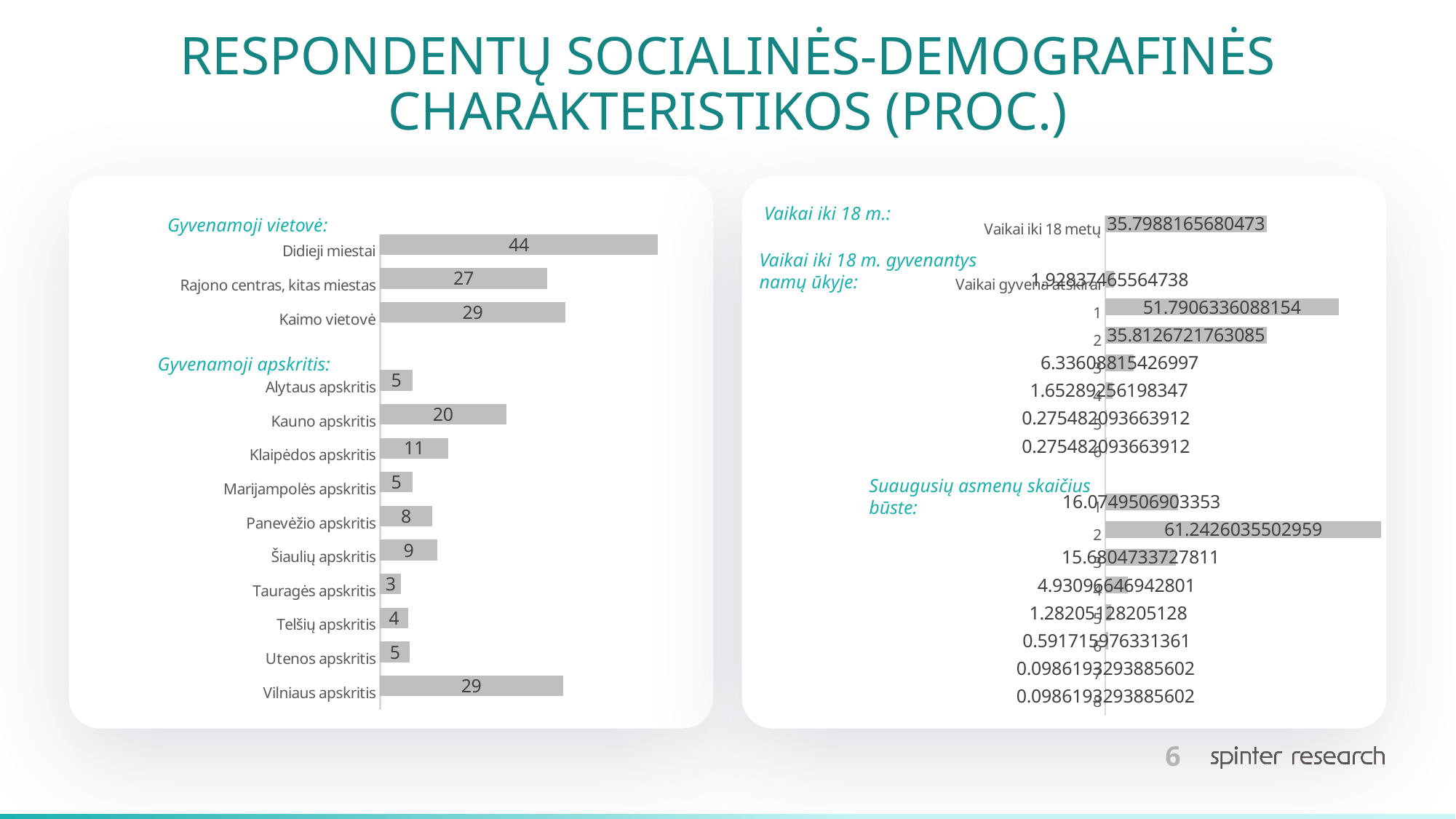
In the left chart, what is the value for Didieji miestai? 44 In the left chart, what is the difference between the values for Vilniaus apskritis and Kauno apskritis? 9 In the left chart, which apskritis (county) has the lowest value? Tauragės apskritis In the left chart, which category has the highest value overall? Didieji miestai In the left chart, which is larger: the value for Šiaulių apskritis or Panevėžio apskritis? Šiaulių apskritis In the left chart, what is the value for Kauno apskritis? 20 In the left chart, what is the value for Klaipėdos apskritis? 11 In the right chart, under 'Suaugusių asmenų skaičius būste', what is the value for category 2? 61.2426035502959 In the right chart, what is the value for 'Vaikai iki 18 metų'? 35.7988165680473 What type of chart is shown on the left side of the slide? Bar chart In the left chart, how many apskritis (county) categories are plotted under 'Gyvenamoji apskritis'? 10 In the left chart, what is the difference between the values for Didieji miestai and Kaimo vietovė? 15